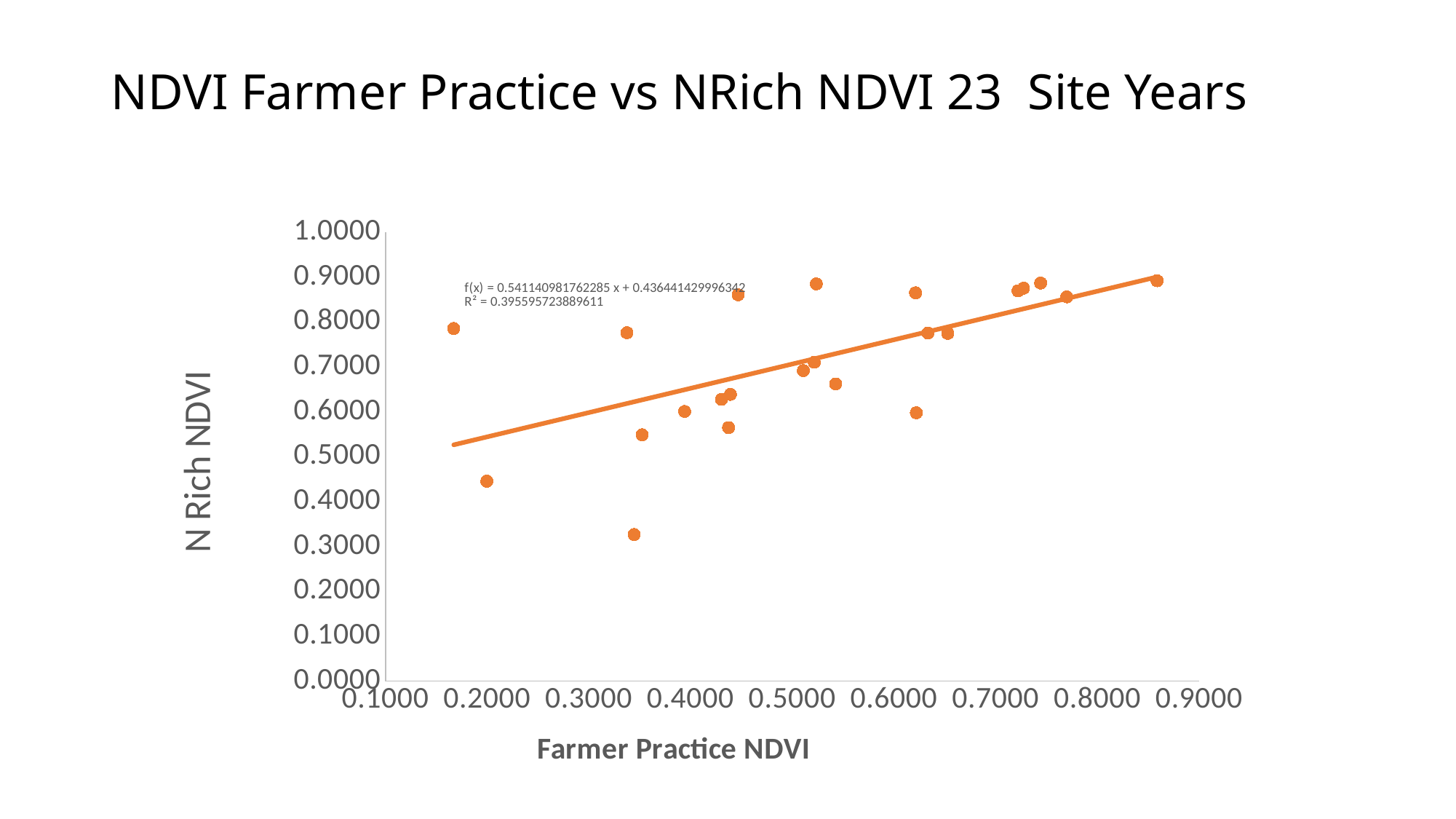
What is the intercept of the trendline equation printed on the chart? 0.436441429996342 What R² value is printed on the chart? 0.395595723889611 Is the N Rich NDVI of the lowest plotted point greater or less than 0.4000? less Is the Farmer Practice NDVI of the rightmost plotted point greater or less than 0.8000? greater How many data points are plotted on the chart? 23 Is the N Rich NDVI at the right end of the trendline greater or less than 0.8000? greater What is the slope of the trendline equation printed on the chart? 0.541140981762285 What is the title of the chart? NDVI Farmer Practice vs NRich NDVI 23 Site Years What is the label of the x axis? Farmer Practice NDVI As Farmer Practice NDVI increases along the x axis, does N Rich NDVI generally rise or fall according to the trendline? rise What kind of chart is shown on the slide? scatter chart